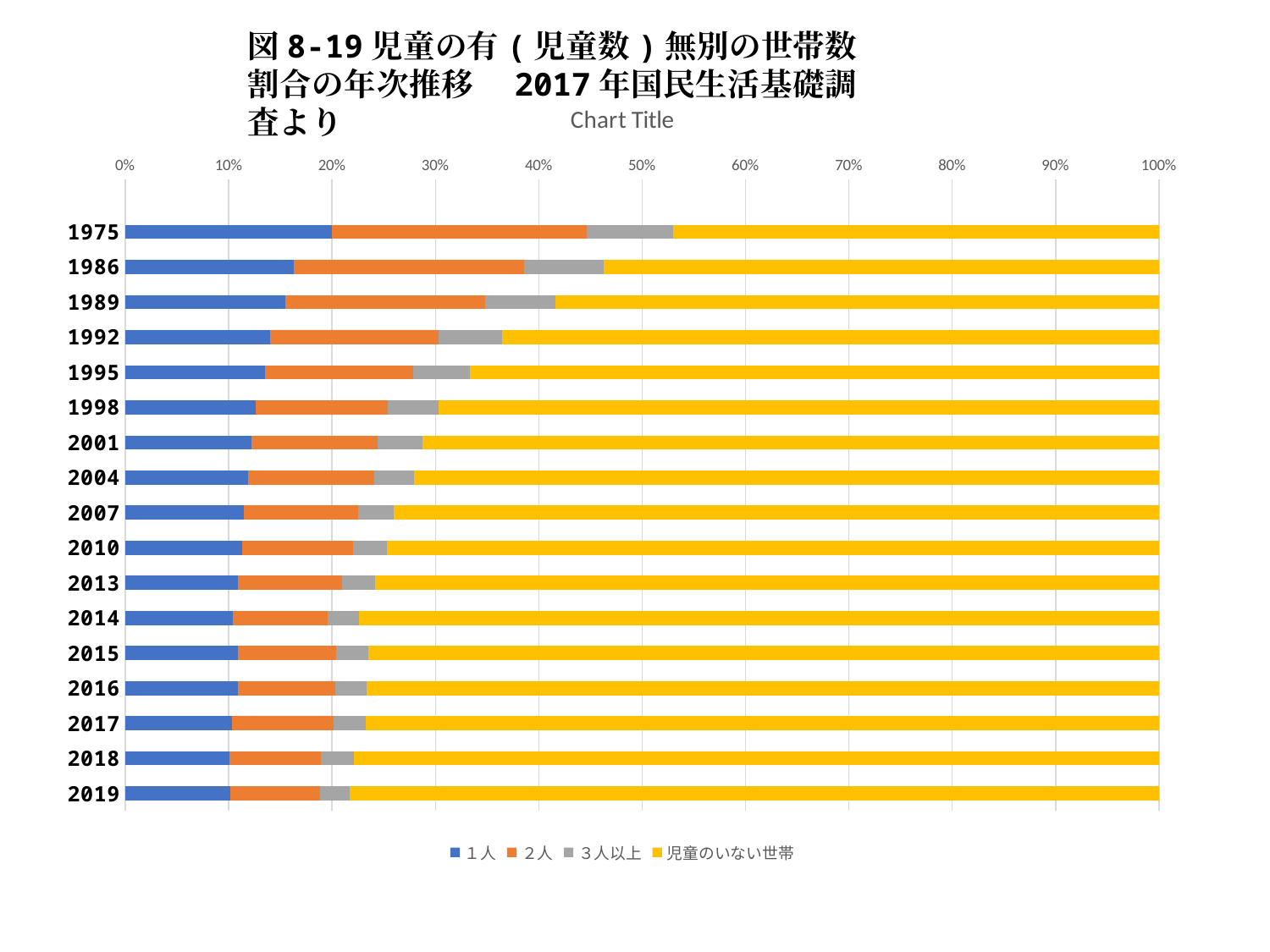
What is the total of the stacked bar for 2019? 100% Is the 1人 segment for 1975 larger or smaller than the 1人 segment for 2019? larger Is the 1人 segment for 1975 greater or less than 10%? greater How many years (categories) are plotted on the chart? 17 Which year has the smallest 児童のいない世帯 segment? 1975 Does the 1人 share rise or fall from 1975 to 2019? fall What kind of chart is shown on the slide? Stacked bar chart Which year has the largest 1人 segment? 1975 What is the placeholder title shown above the plot area? Chart Title Is the 児童のいない世帯 segment for 2019 greater or less than 70%? greater What are the series names listed in the legend? 1人, 2人, 3人以上, 児童のいない世帯 How many series does the legend list? 4